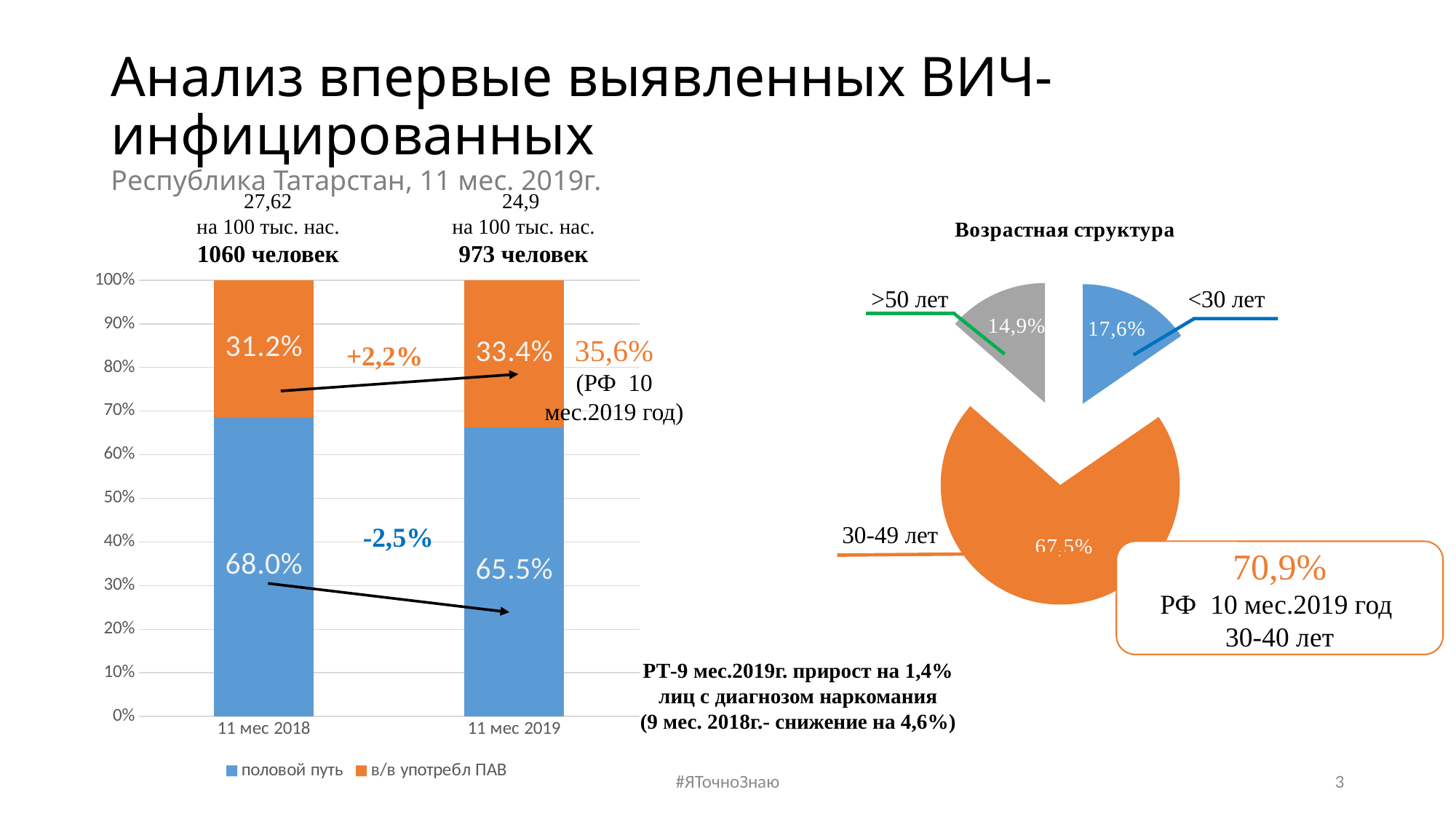
On the left stacked bar chart, what is the value for половой путь in 11 мес 2018? 68.0% On the left stacked bar chart, what is the value for половой путь in 11 мес 2019? 65.5% On the pie chart Возрастная структура, which is larger: <30 лет or >50 лет? <30 лет On the left stacked bar chart, does the value for половой путь rise or fall from 11 мес 2018 to 11 мес 2019? fall On the pie chart Возрастная структура, which age group has the smallest share? >50 лет On the pie chart Возрастная структура, what is the value for >50 лет? 14,9% On the left stacked bar chart, how many series does the legend list? 2 On the left stacked bar chart, how many categories are shown on the x axis? 2 On the pie chart Возрастная структура, what share does the 30-49 лет slice have? 67,5% On the left stacked bar chart, what is the value for в/в употребл ПАВ in 11 мес 2018? 31.2% What kind of chart is the chart on the left of the slide? stacked bar chart On the left stacked bar chart, what is the value for в/в употребл ПАВ in 11 мес 2019? 33.4%